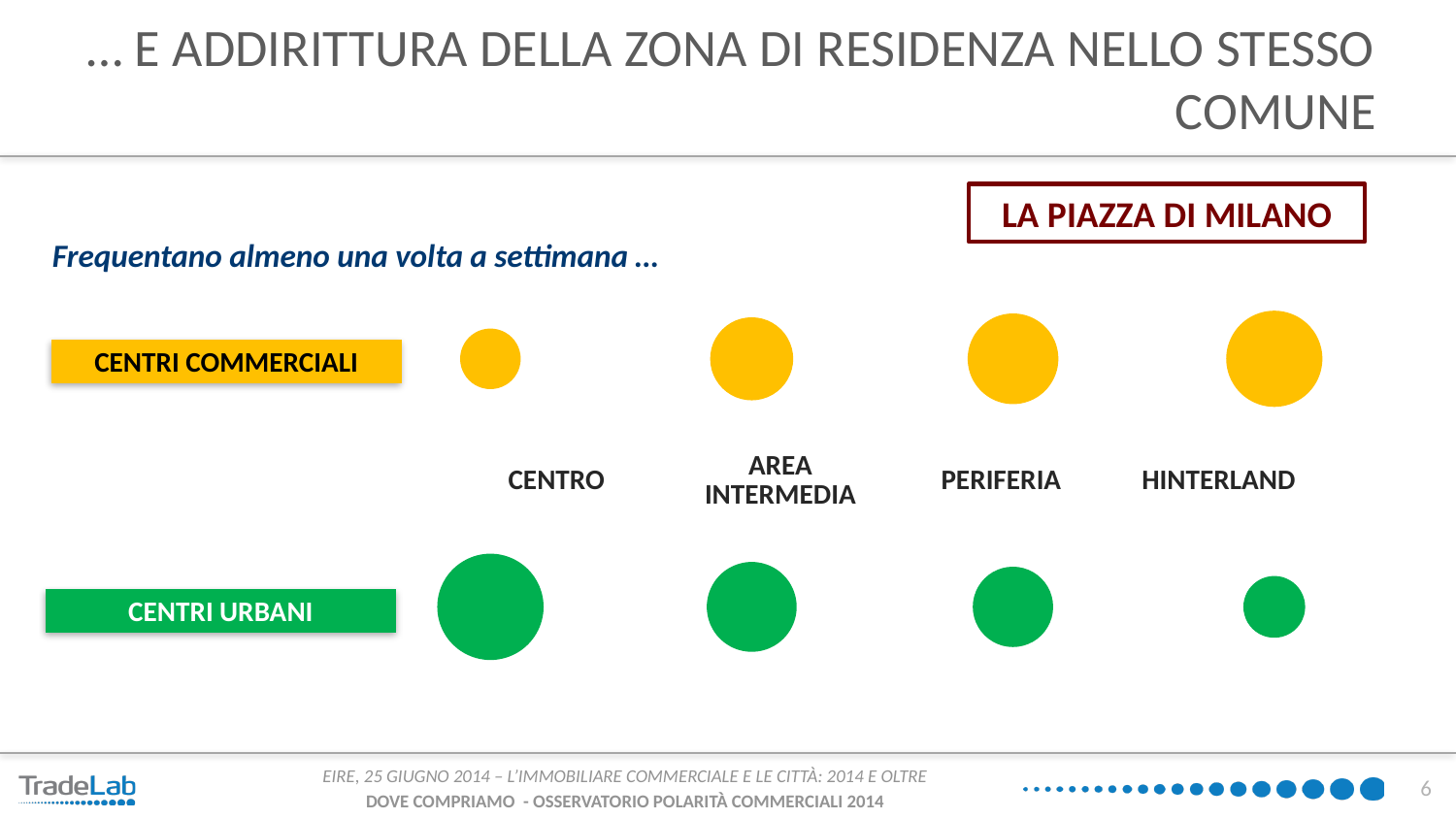
Do the CENTRI URBANI bubbles grow or shrink moving from CENTRO to HINTERLAND? Shrink What kind of chart is used on this slide to show the frequency of visits? Bubble chart Do the CENTRI COMMERCIALI bubbles grow or shrink moving from CENTRO to HINTERLAND? Grow For CENTRI COMMERCIALI, which residence zone has the smallest bubble? CENTRO How many residence zones (categories) are shown along the horizontal axis? 4 In the HINTERLAND zone, which is larger: the CENTRI COMMERCIALI bubble or the CENTRI URBANI bubble? CENTRI COMMERCIALI For CENTRI COMMERCIALI, which residence zone has the largest bubble? HINTERLAND In the CENTRO zone, which is larger: the CENTRI COMMERCIALI bubble or the CENTRI URBANI bubble? CENTRI URBANI What colour are the bubbles for CENTRI URBANI? Green For CENTRI URBANI, which residence zone has the largest bubble? CENTRO How many series (types of centre) are shown on the chart? 2 For CENTRI URBANI, which residence zone has the smallest bubble? HINTERLAND